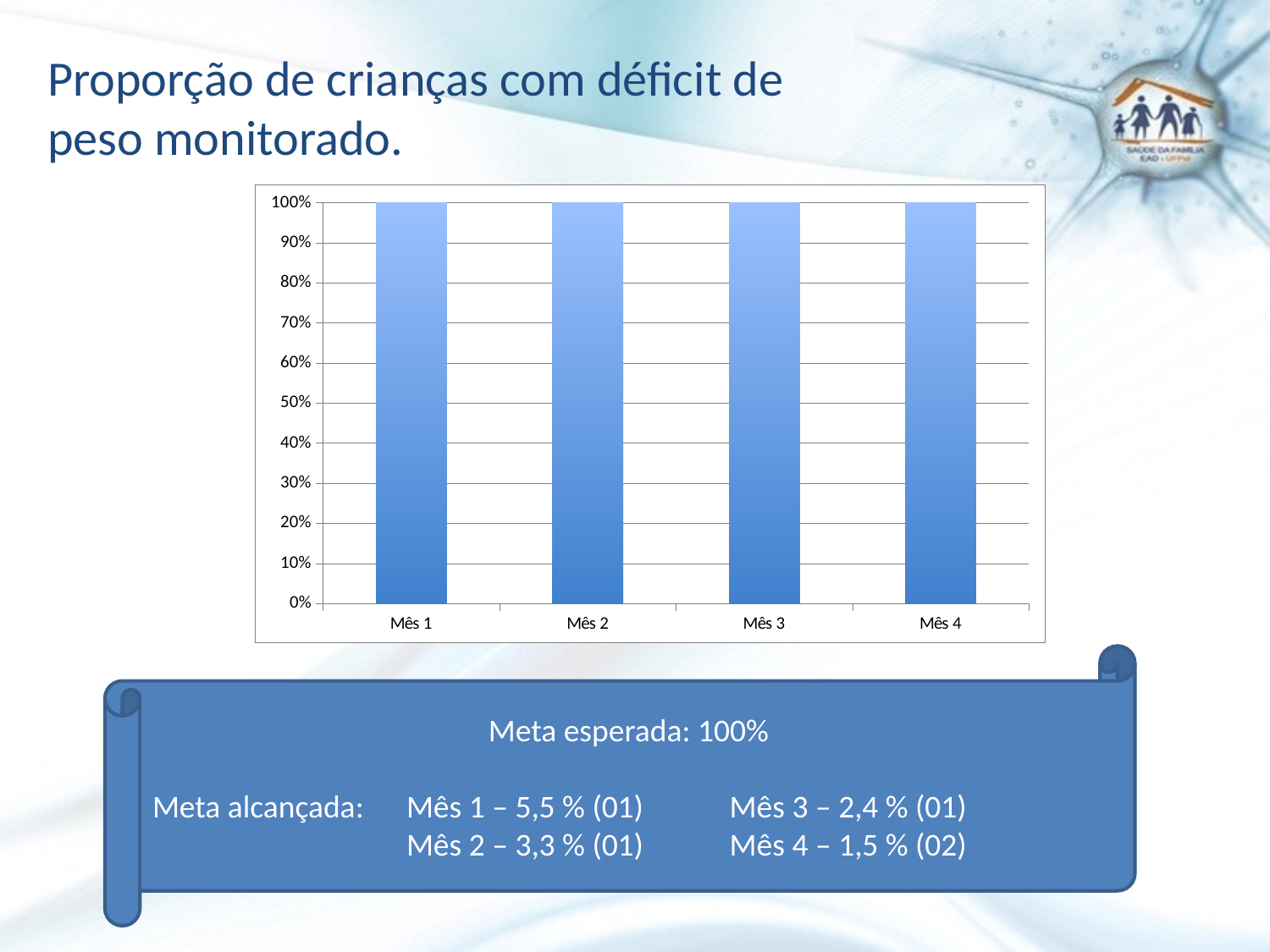
What is the highest value shown on the y axis of the chart? 100% Is the value for Mês 3 greater or less than 50%? greater What is the value of the bar for Mês 2? 100% How many categories (months) are shown on the x axis of the chart? 4 What is the value of the bar for Mês 1? 100% What is the difference between the values for Mês 1 and Mês 4? 0% What is the label of the first category on the x axis? Mês 1 What is the value of the bar for Mês 3? 100% What kind of chart is shown on the slide? bar chart Is the value for Mês 1 greater or less than 90%? greater What is the value of the bar for Mês 4? 100% Do the bar values rise, fall, or stay the same from Mês 1 to Mês 4? stay the same